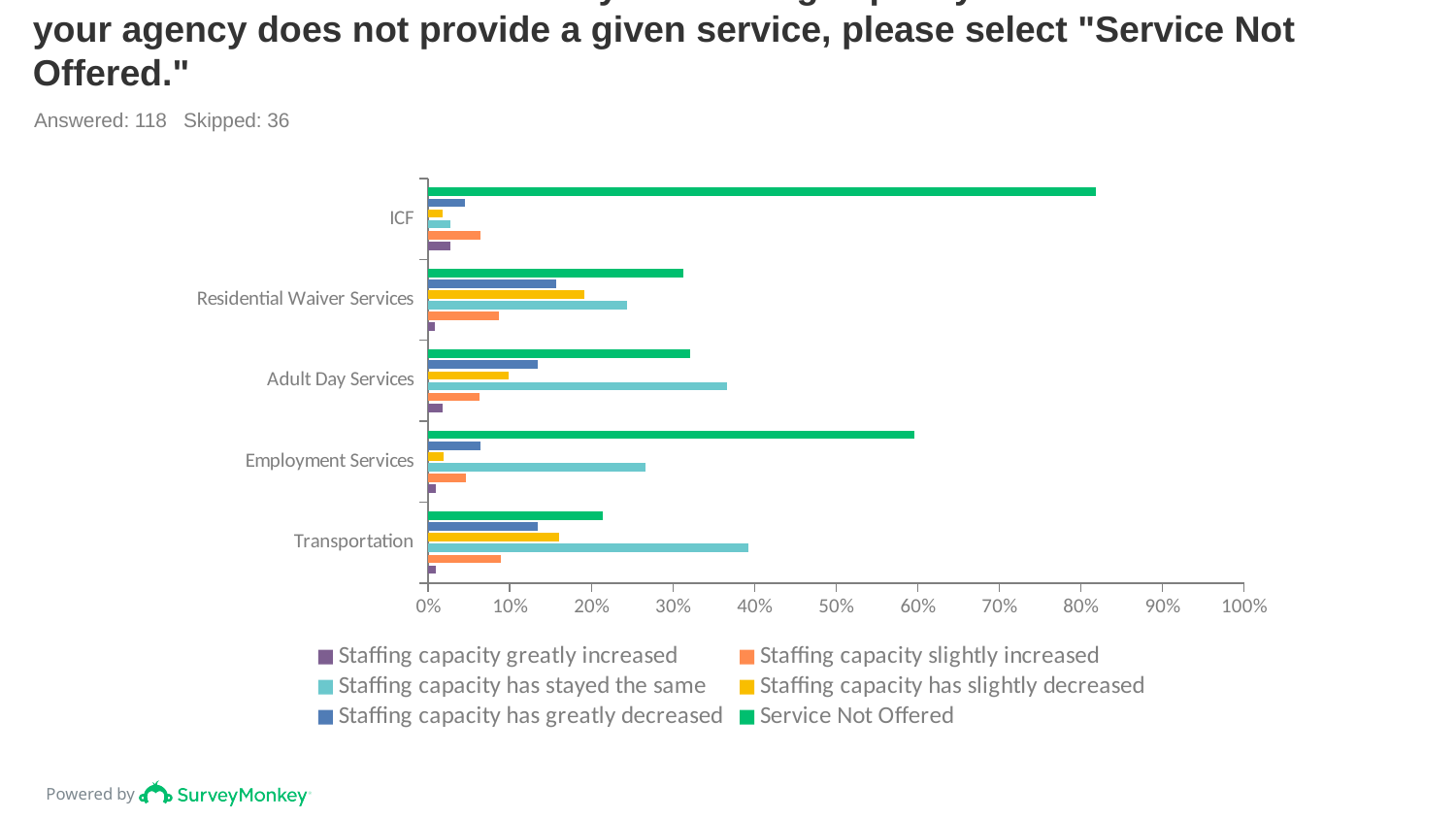
Is the value for "Service Not Offered" for ICF greater or less than 80%? greater Which legend entry is shown in green? Service Not Offered Is the value for "Staffing capacity has stayed the same" for Transportation greater or less than 30%? greater For Adult Day Services, which is larger: "Staffing capacity has stayed the same" or "Service Not Offered"? Staffing capacity has stayed the same How many service categories are plotted on the chart? 5 How many series does the legend list? 6 What kind of chart is shown on the slide? bar chart Which service category has the lowest value for "Service Not Offered"? Transportation Which service category has the highest value for "Service Not Offered"? ICF For Residential Waiver Services, which is larger: "Staffing capacity has slightly decreased" or "Staffing capacity slightly increased"? Staffing capacity has slightly decreased Is the value for "Staffing capacity has stayed the same" for ICF greater or less than 10%? less